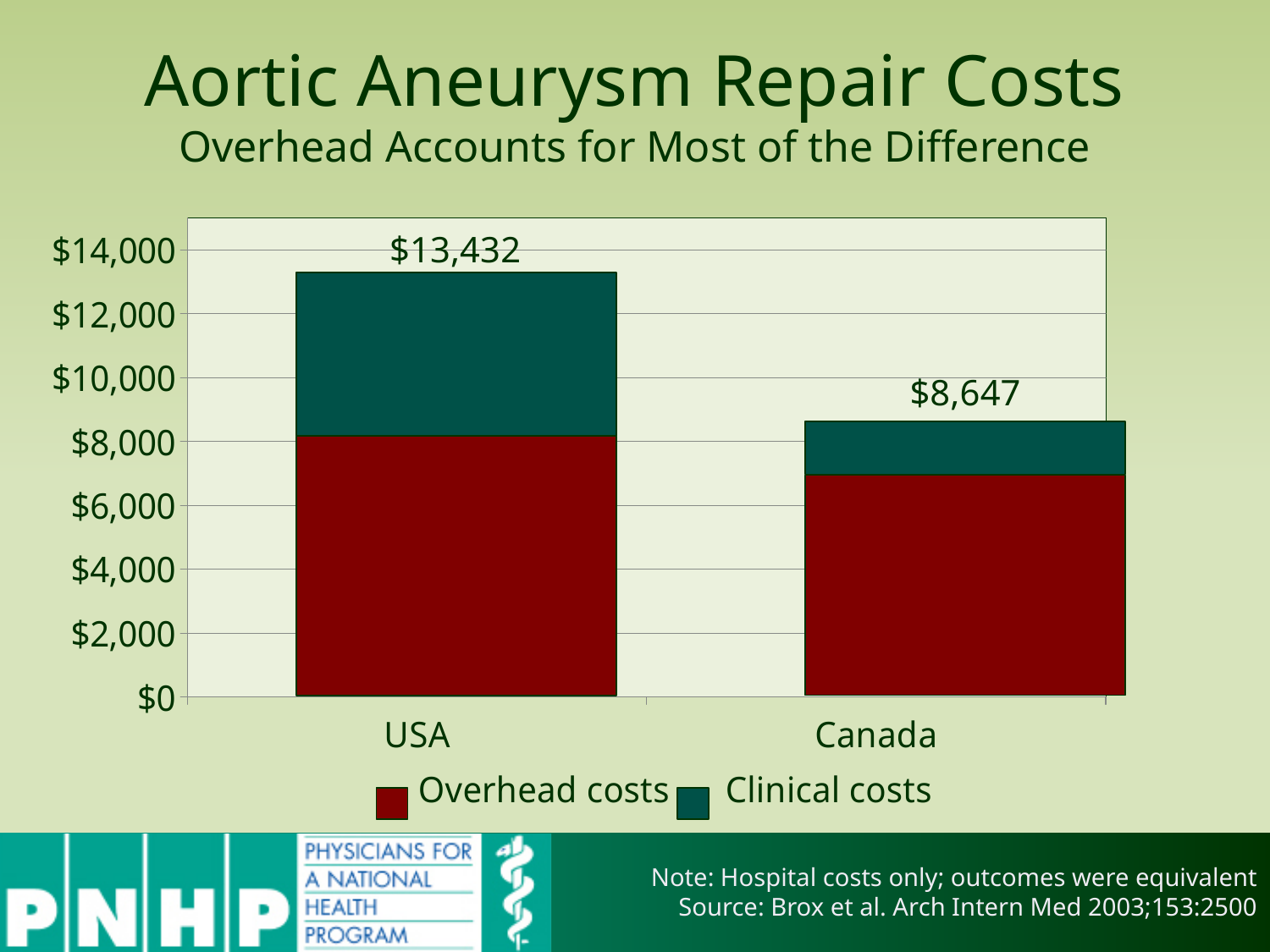
How many countries are compared in the chart? 2 How many series does the legend list? 2 Which country has the lower total repair cost? Canada Is the total cost for the USA larger or smaller than the total cost for Canada? larger Is the overhead costs value for Canada greater or less than $8,000? less Is the total cost for Canada greater or less than $10,000? less What is the difference between the USA total cost and the Canada total cost? $4,785 Which country has the higher total repair cost? USA What type of chart is shown on the slide? Stacked bar chart Is the overhead costs value for Canada greater or less than $6,000? greater What is the total aortic aneurysm repair cost shown for Canada? $8,647 What is the total aortic aneurysm repair cost shown for the USA? $13,432